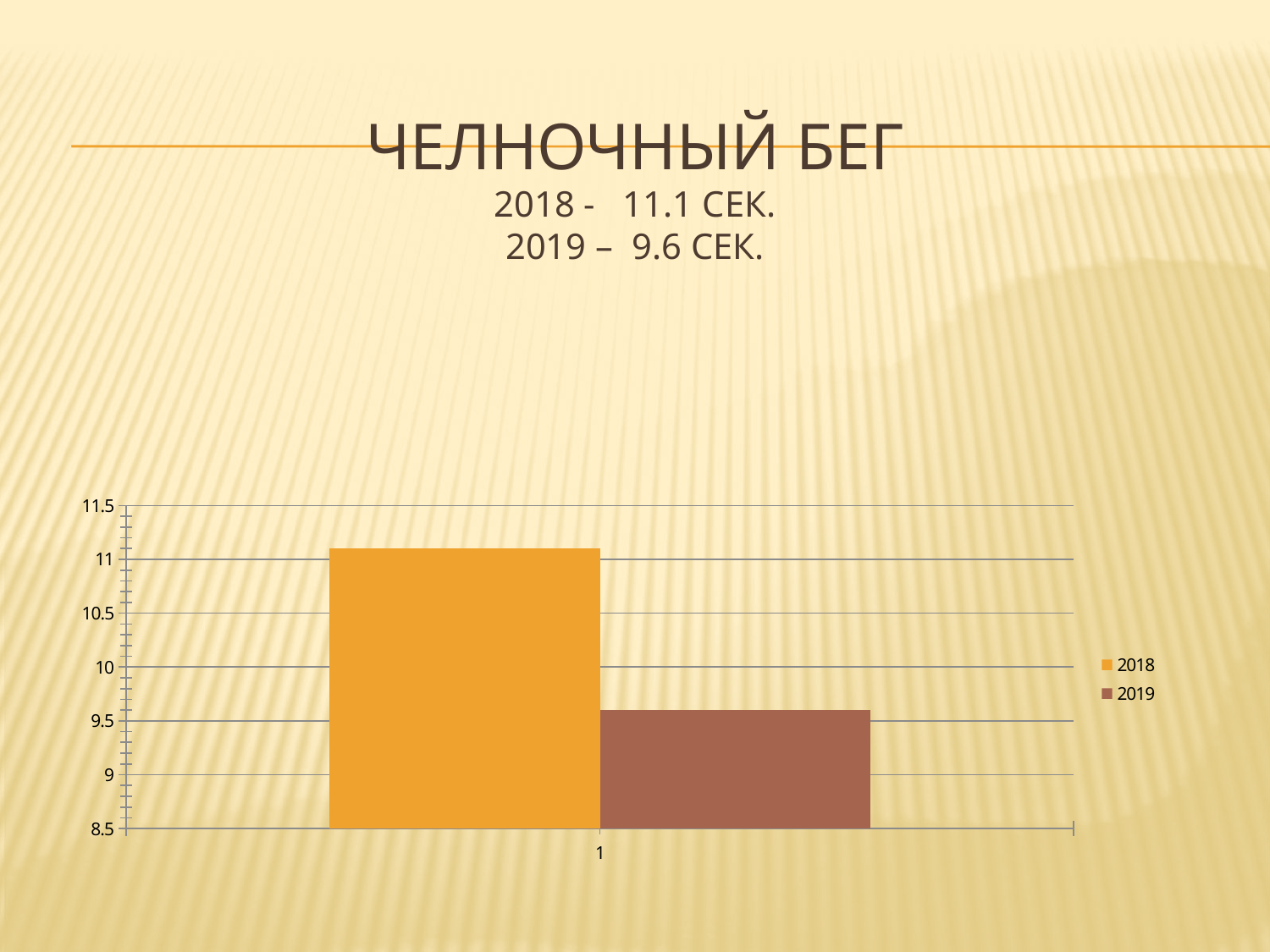
Is the value for 2019 greater or less than 10? less What are the two series listed in the chart legend? 2018 and 2019 What kind of chart is shown on the slide? bar chart What is the value for 2019 according to the slide? 9.6 СЕК. What is the title of the slide above the chart? ЧЕЛНОЧНЫЙ БЕГ Which series has the highest value in the chart? 2018 How many series does the chart legend list? 2 Which series has the lowest value in the chart? 2019 Is the value for 2018 greater or less than 10.5? greater Which series has the higher value, 2018 or 2019? 2018 What is the value for 2018 according to the slide? 11.1 СЕК. What is the difference between the 2018 value and the 2019 value? 1.5